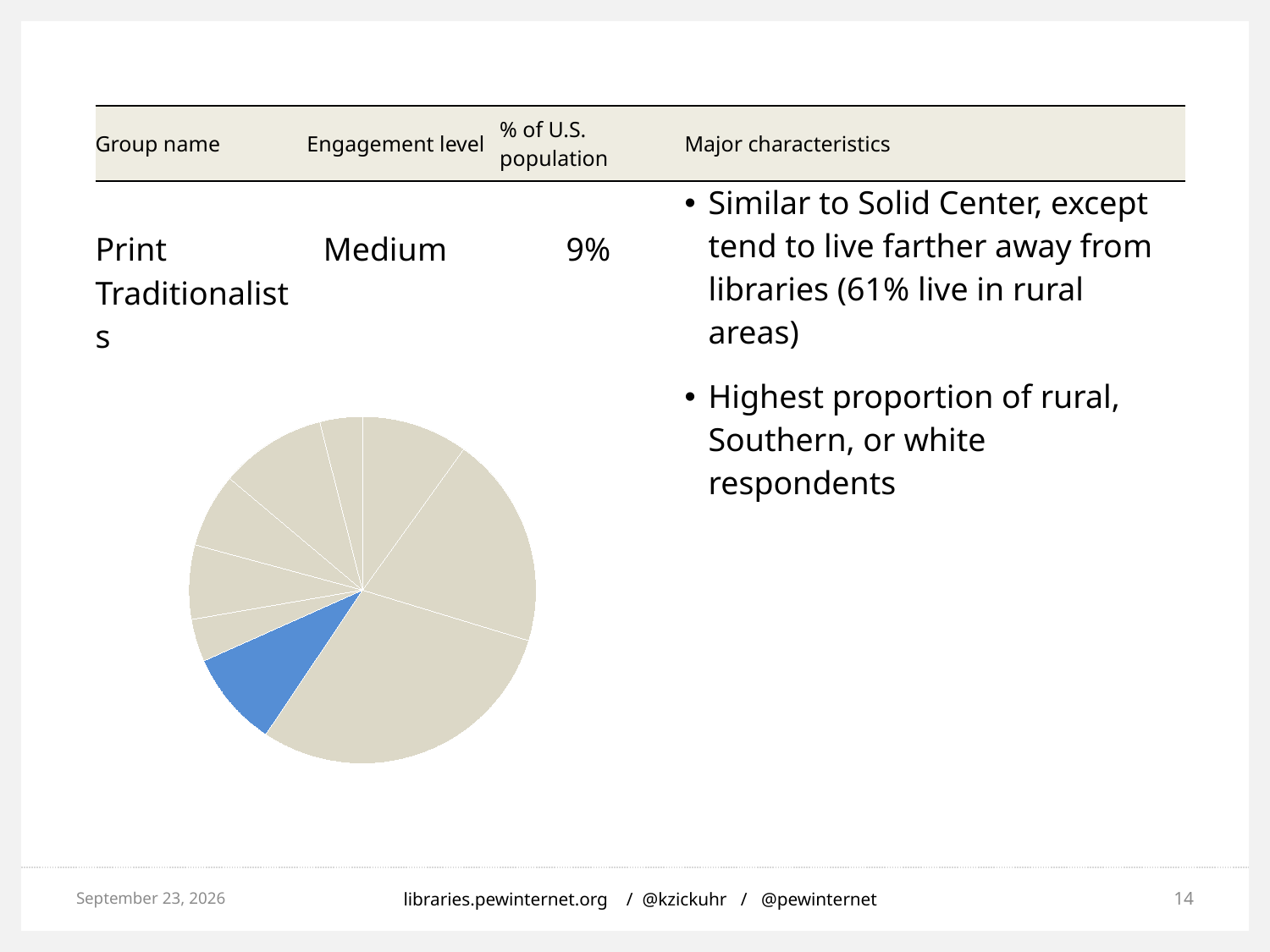
Which group name in the table does the highlighted slice of the pie chart correspond to? Print Traditionalists What engagement level does the table give for the group represented by the highlighted slice? Medium Does the pie chart have a legend? No Is the highlighted blue slice of the pie chart greater or less than 25% of the pie? less What colour is the highlighted slice of the pie chart? blue Is the highlighted blue slice of the pie chart greater or less than 50% of the pie? less What kind of chart is shown on the slide? pie chart According to the table on the slide, what share of the U.S. population does the highlighted (blue) slice of the pie chart represent? 9% How many slices does the pie chart have? 9 Which is larger in the pie chart: the highlighted blue slice or the large unshaded slice on the right? the large unshaded slice on the right